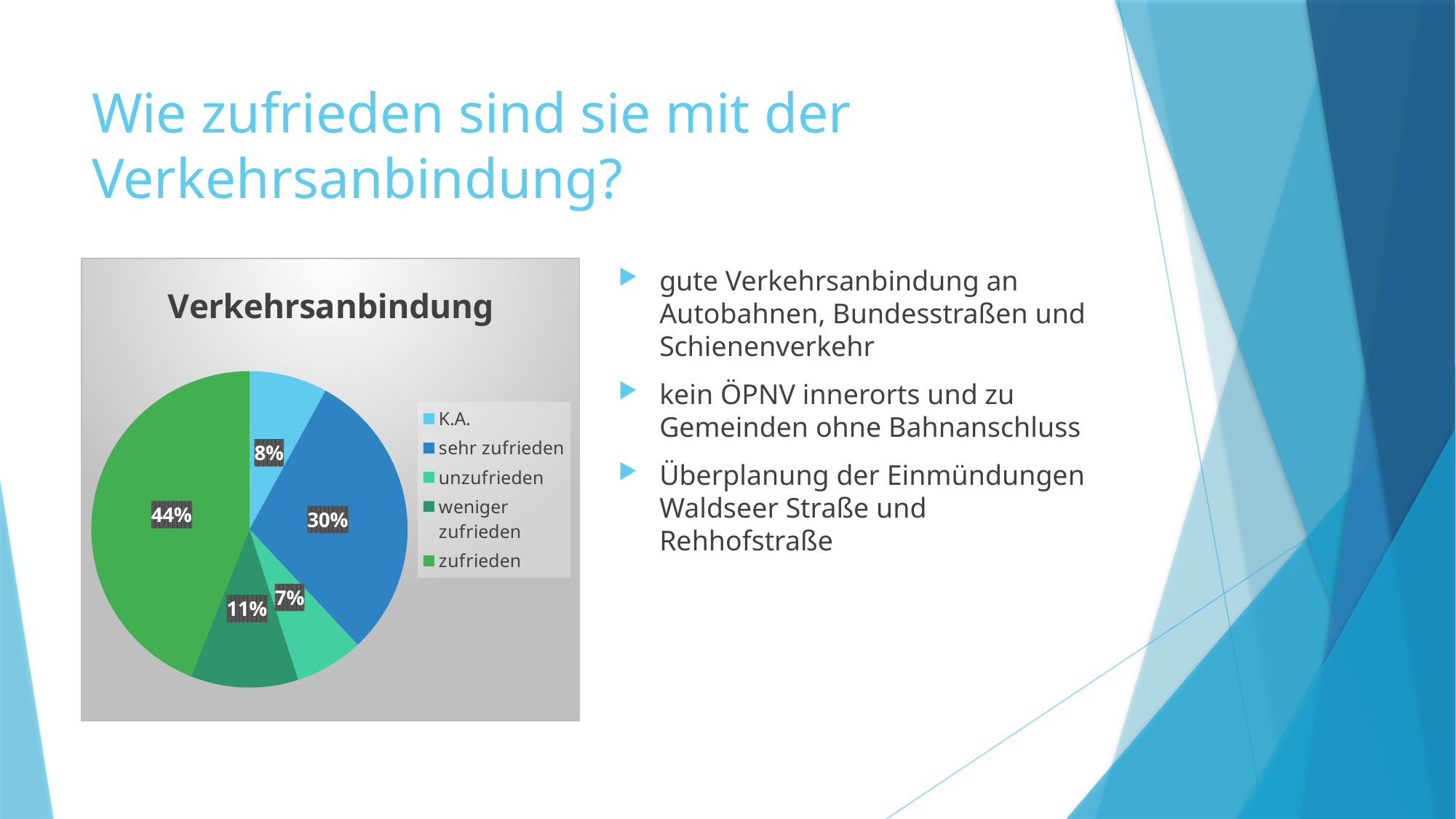
Which is larger, the share for "weniger zufrieden" or the share for "K.A."? weniger zufrieden What is the difference in percentage points between "zufrieden" and "sehr zufrieden"? 14 Which category has the largest slice of the pie? zufrieden What share of the pie is labelled "K.A."? 8% Which category has the smallest slice of the pie? unzufrieden What share of the pie is labelled "zufrieden"? 44% What share of the pie is labelled "sehr zufrieden"? 30% What is the title of the chart? Verkehrsanbindung What share of the pie is labelled "weniger zufrieden"? 11% How many categories does the legend list? 5 What share of the pie is labelled "unzufrieden"? 7% What kind of chart is shown on the slide? pie chart